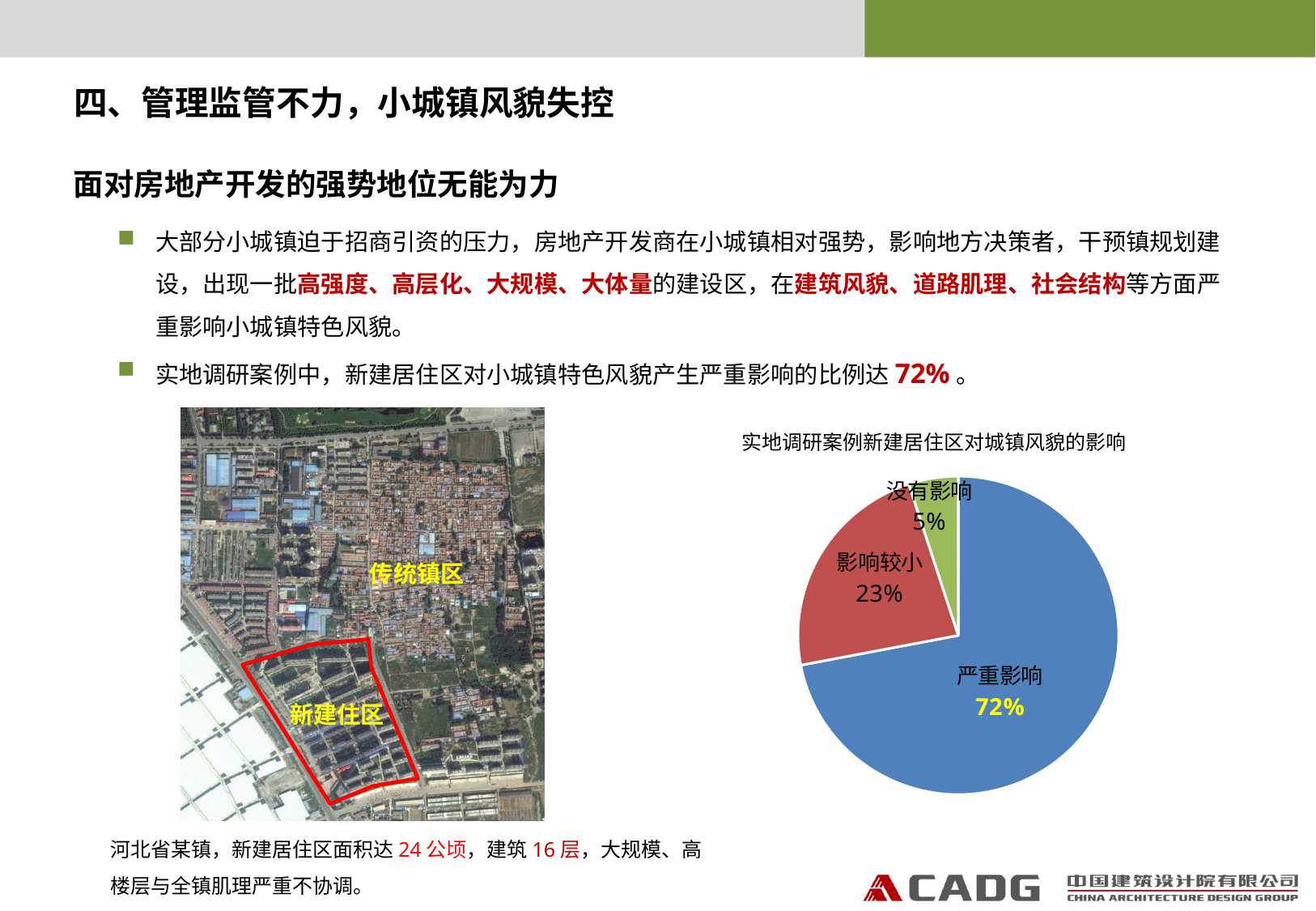
Which is larger, the 影响较小 slice or the 没有影响 slice? 影响较小 What colour is the 严重影响 slice in the pie chart? blue What is the difference in percentage points between the 严重影响 slice and the 影响较小 slice? 49 What share of the pie is labelled 影响较小? 23% What is the title of the pie chart? 实地调研案例新建居住区对城镇风貌的影响 What share of the pie is labelled 没有影响? 5% Which slice of the pie chart is the largest? 严重影响 Which slice of the pie chart is the smallest? 没有影响 What kind of chart is shown on the slide? pie chart What share of the pie is labelled 严重影响? 72% How many slices does the pie chart have? 3 What is the difference in percentage points between the 影响较小 slice and the 没有影响 slice? 18